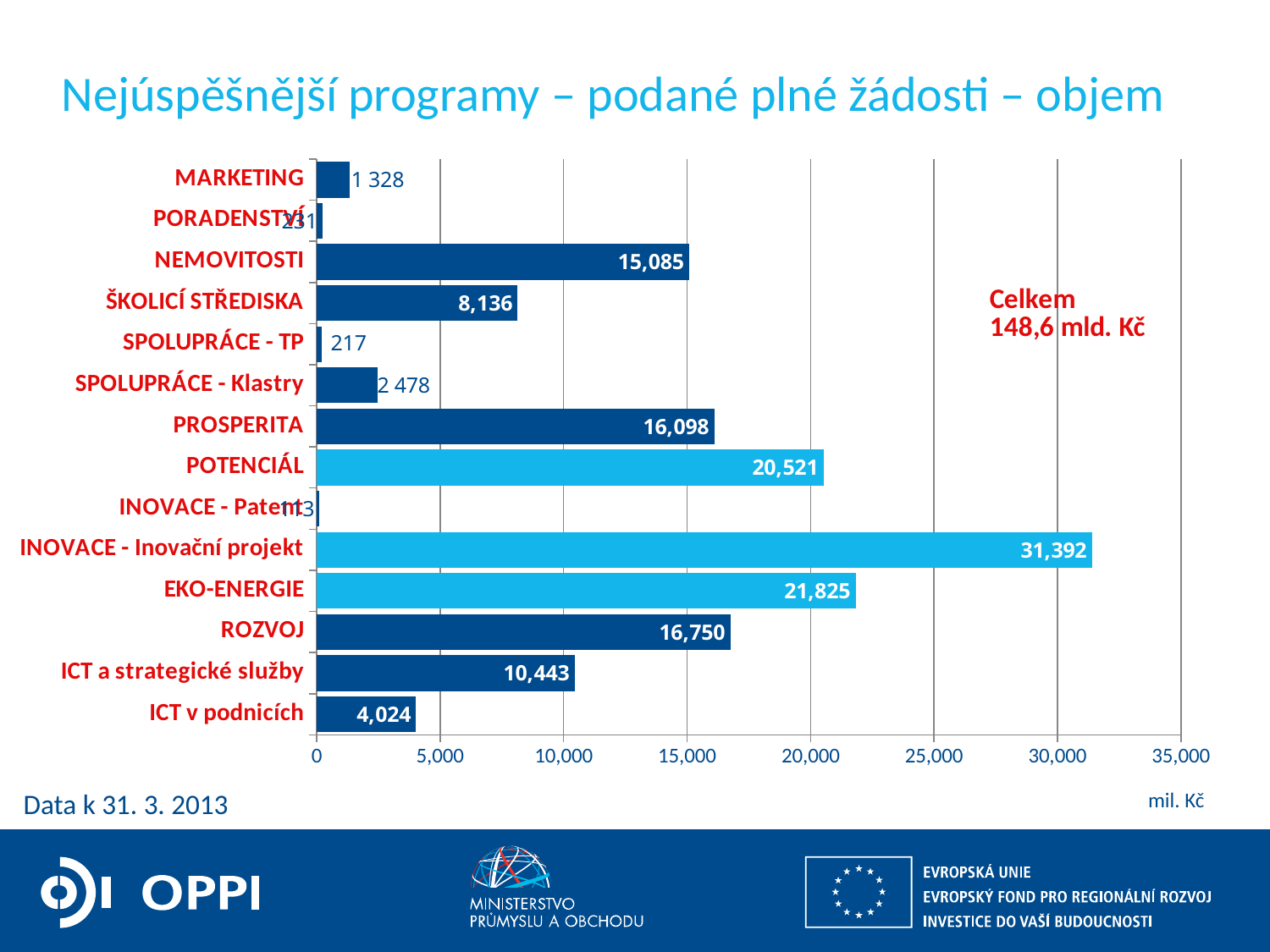
Which program has the highest value? INOVACE - Inovační projekt What is the difference between the values for POTENCIÁL and PROSPERITA? 4,423 What is the value for INOVACE - Inovační projekt? 31,392 How many programs are shown in the chart? 14 What is the value for ŠKOLICÍ STŘEDISKA? 8,136 What kind of chart is shown on the slide? bar chart What is the value for EKO-ENERGIE? 21,825 Which is larger, the value for EKO-ENERGIE or the value for POTENCIÁL? EKO-ENERGIE Is the value for ICT a strategické služby greater or less than 10,000? greater What is the value for ICT v podnicích? 4,024 What is the difference between the values for ROZVOJ and NEMOVITOSTI? 1,665 What total is stated in the text annotation on the chart? 148,6 mld. Kč